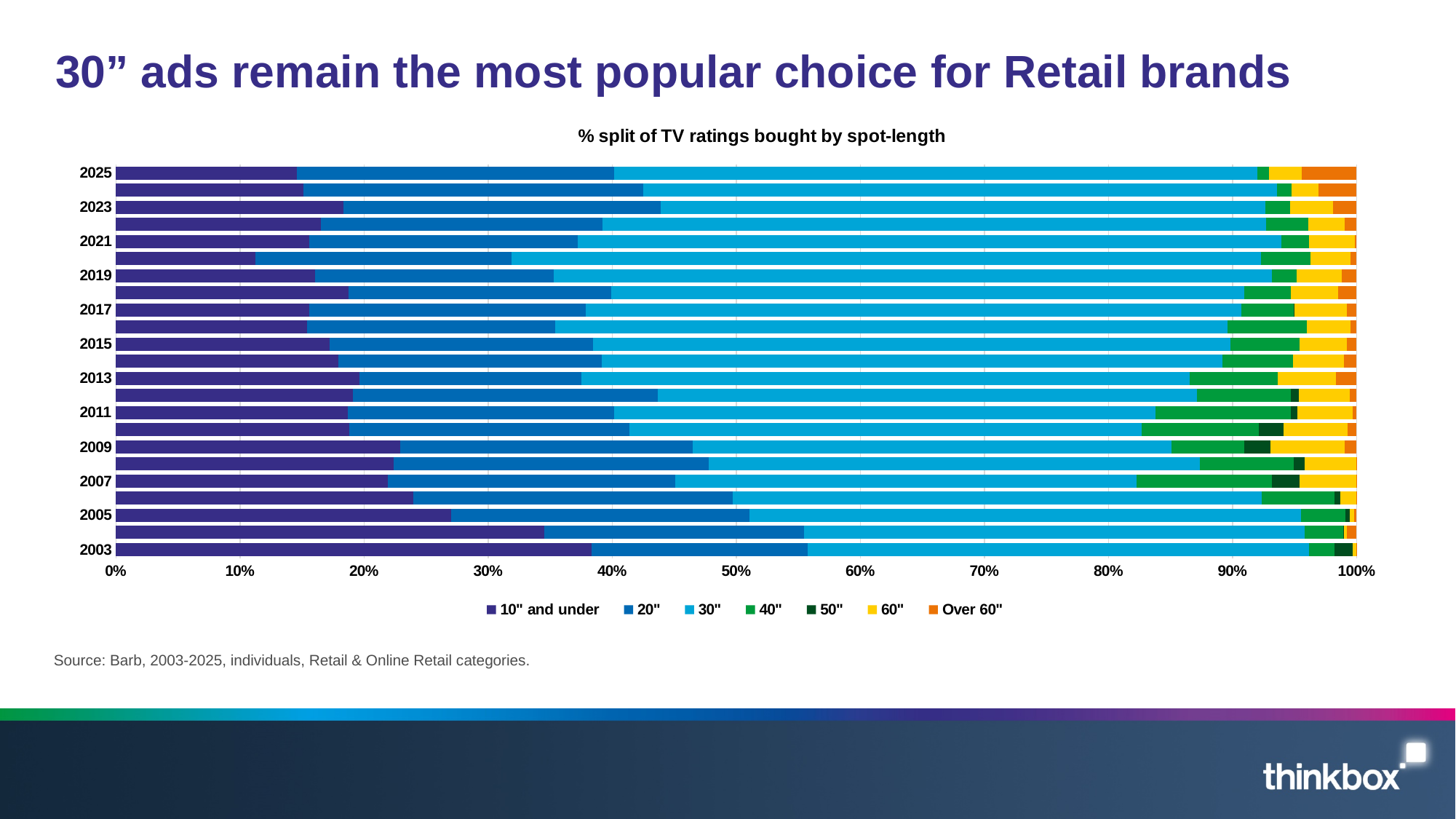
Which spot-length has the largest share of TV ratings bought in 2025? 30" What kind of chart is shown on the slide? Stacked bar chart How many series does the legend list? 7 What is the first entry in the chart legend? 10" and under Is the share for 10" and under in 2003 greater or less than 30%? greater Which year has the largest share for 10" and under? 2003 What is the subtitle of the chart? % split of TV ratings bought by spot-length Is the 40" share in 2011 larger or smaller than the 40" share in 2025? larger Is the share for 10" and under in 2025 greater or less than 20%? less Is the share for 10" and under in 2003 larger or smaller than in 2025? larger Does the share for 10" and under rise or fall from 2003 to 2025? fall How many years (bars) are plotted in the chart? 23